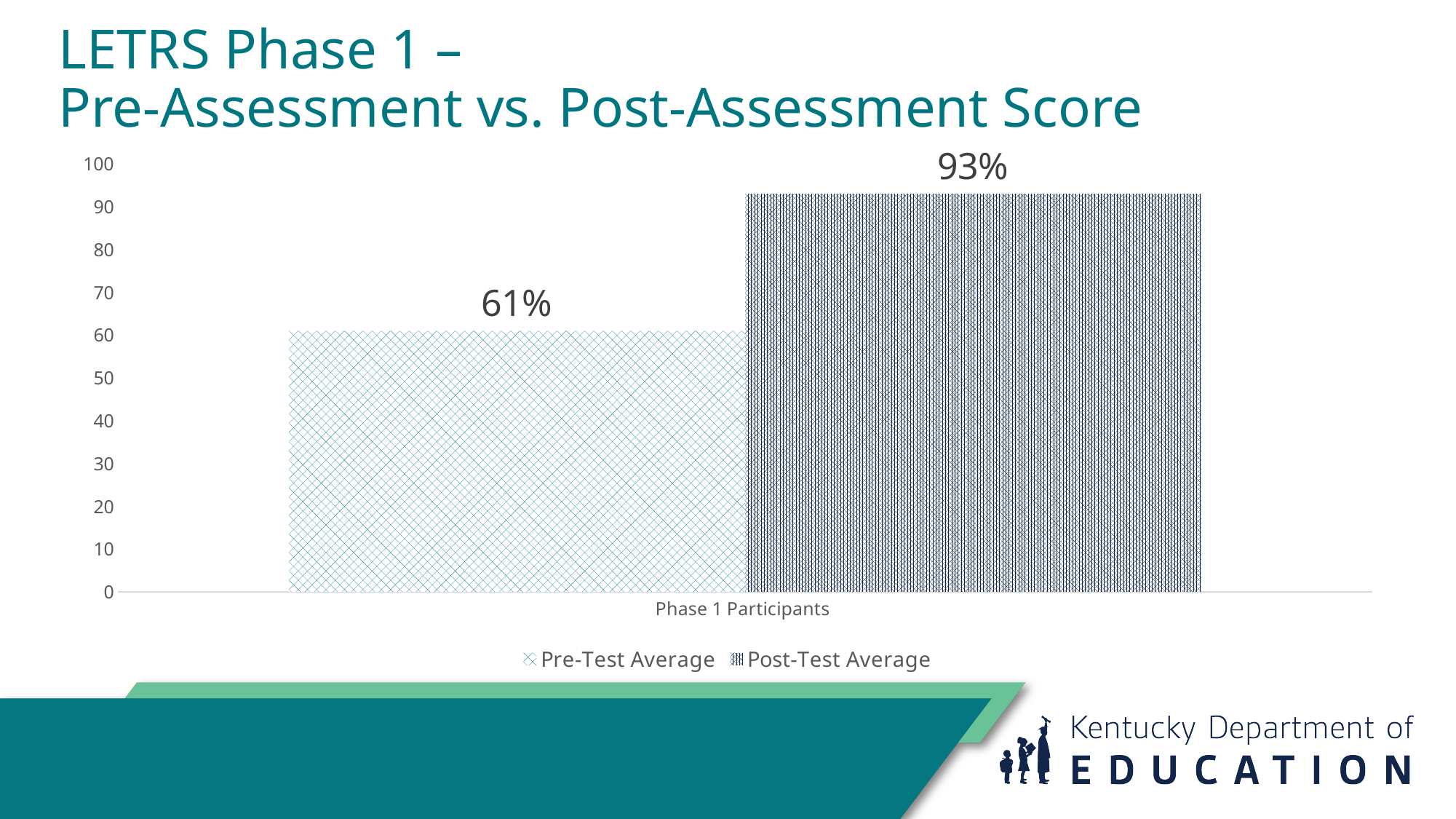
What is the Pre-Test Average for Phase 1 Participants? 61% What is the Post-Test Average for Phase 1 Participants? 93% What is the title of the slide's chart? LETRS Phase 1 – Pre-Assessment vs. Post-Assessment Score What is the difference between the Post-Test Average and the Pre-Test Average? 32% How many categories are shown on the x axis? 1 Which series has the lower value: Pre-Test Average or Post-Test Average? Pre-Test Average What kind of chart is shown on the slide? bar chart How many series does the legend list? 2 Is the Pre-Test Average greater or less than 70? less What is the category label on the x axis? Phase 1 Participants Which series has the higher value: Pre-Test Average or Post-Test Average? Post-Test Average Is the Post-Test Average greater or less than 90? greater